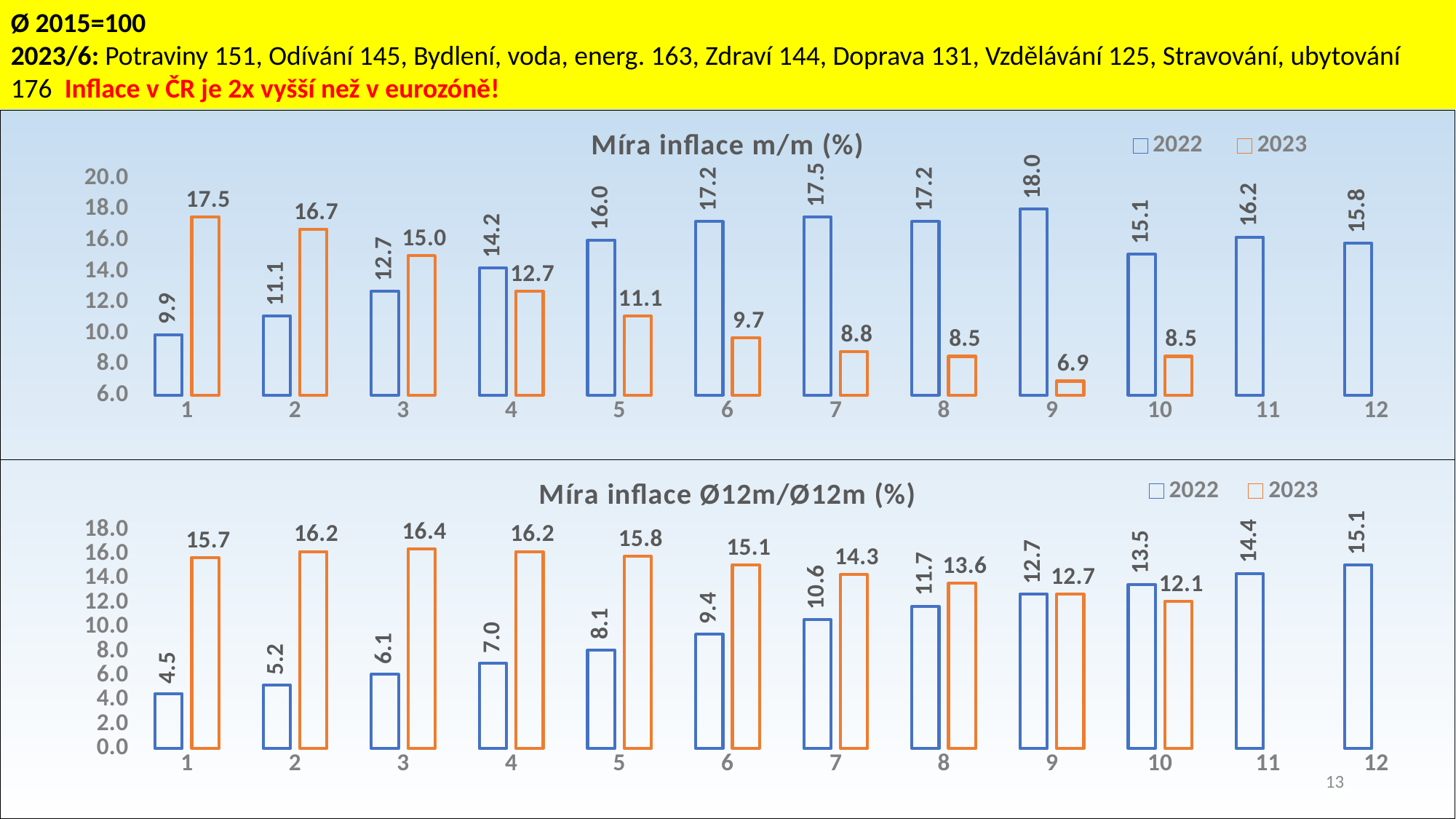
In the chart titled "Míra inflace m/m (%)", what is the value for 2022 in month 9? 18.0 What type of chart is the top chart on the slide? bar chart In the chart titled "Míra inflace m/m (%)", what is the value for 2023 in month 1? 17.5 In the chart titled "Míra inflace m/m (%)", do the 2023 values rise or fall from month 1 to month 9? fall In the chart titled "Míra inflace m/m (%)", which month has the lowest 2023 value? 9 How many series does the legend of the chart titled "Míra inflace Ø12m/Ø12m (%)" list? 2 In the chart titled "Míra inflace Ø12m/Ø12m (%)", which month has the highest 2023 value? 3 In the chart titled "Míra inflace Ø12m/Ø12m (%)", do the 2022 values rise or fall from month 1 to month 12? rise In the chart titled "Míra inflace m/m (%)", how many months have a 2023 value plotted? 10 In the chart titled "Míra inflace m/m (%)", what is the difference between the 2022 and 2023 values in month 7? 8.7 In the chart titled "Míra inflace Ø12m/Ø12m (%)", which is larger in month 10, the 2022 value or the 2023 value? 2022 In the chart titled "Míra inflace Ø12m/Ø12m (%)", what is the value for 2022 in month 1? 4.5